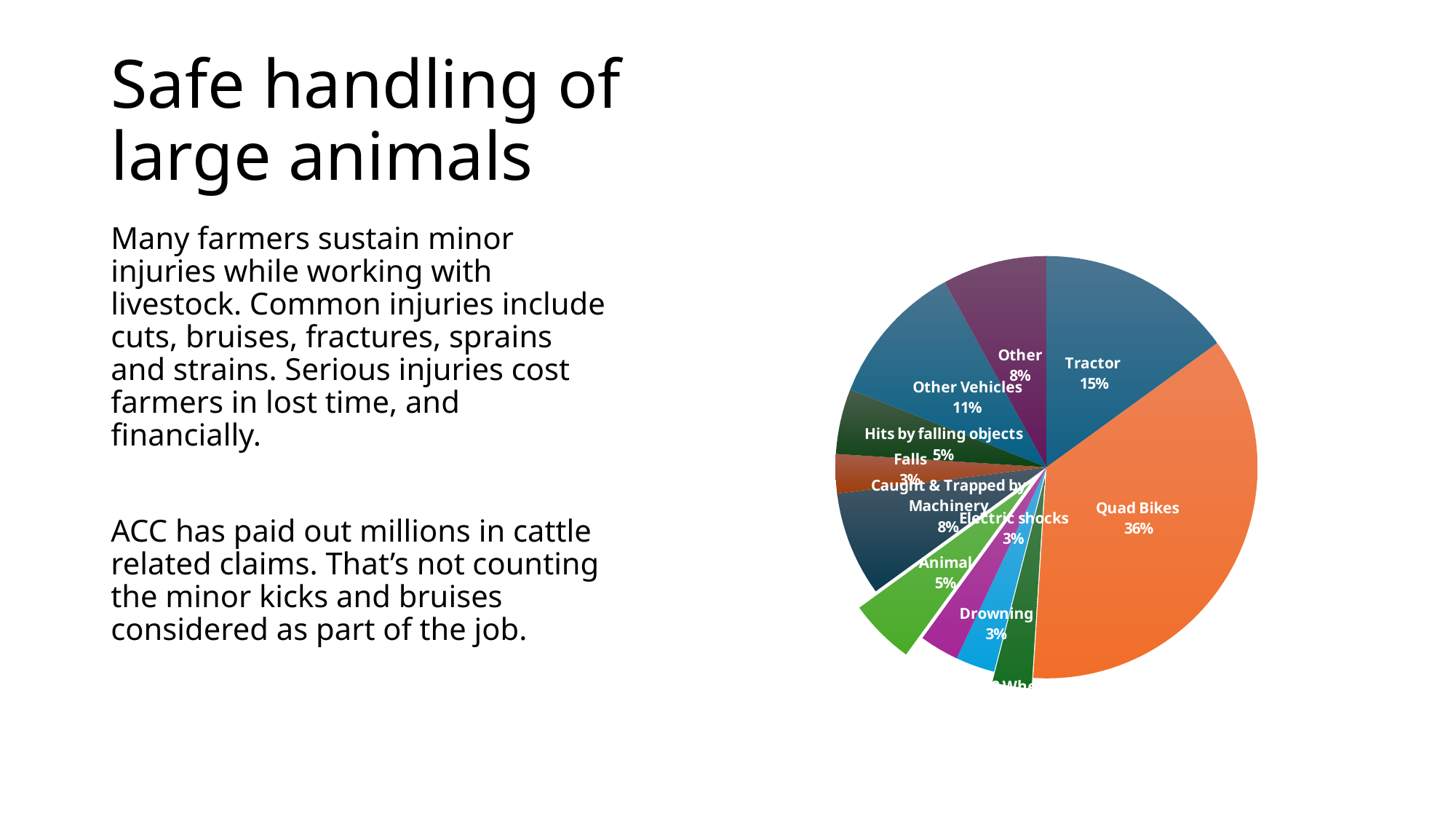
How many percentage points larger is Quad Bikes than Tractor? 21 What percentage is shown for Tractor? 15% What percentage is shown for Drowning? 3% Which is larger, Other Vehicles or Other? Other Vehicles Which category has the largest slice of the pie? Quad Bikes What percentage is shown for Other Vehicles? 11% What colour is the Quad Bikes slice? orange What kind of chart is shown on the slide? pie chart What percentage of the pie is Quad Bikes? 36% What percentage is shown for Hits by falling objects? 5% What percentage is shown for Caught & Trapped by Machinery? 8% What share of the pie does the Animal slice represent? 5%